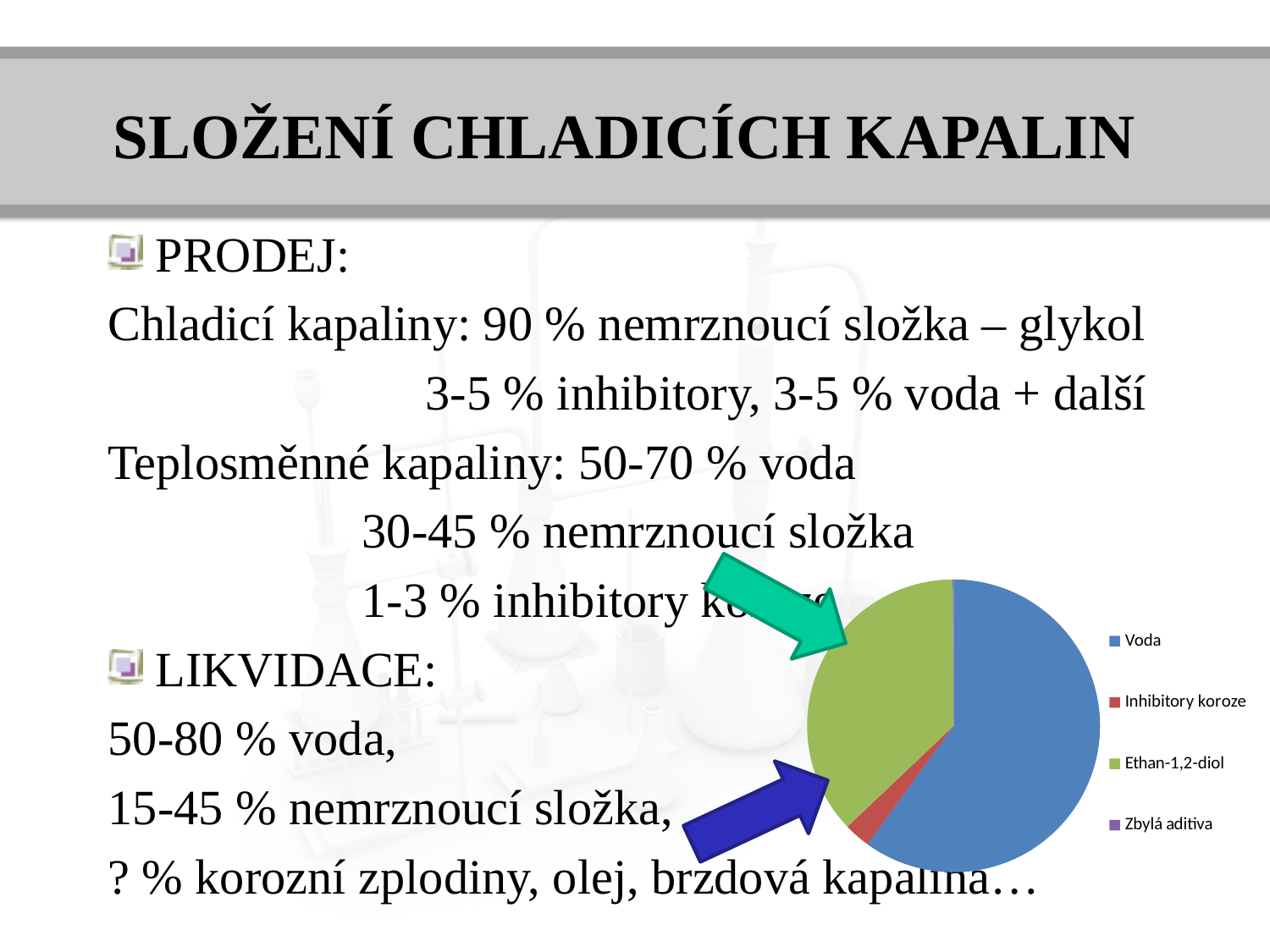
What kind of chart is shown on the slide? pie chart How many entries does the legend of the pie chart list? 4 Which slice is larger in the pie chart, Voda or Ethan-1,2-diol? Voda Which category has the largest slice in the pie chart? Voda What colour is the Voda slice in the pie chart? blue Which slice is larger in the pie chart, Voda or Inhibitory koroze? Voda Which legend entry of the pie chart is shown in green? Ethan-1,2-diol Which slice is larger in the pie chart, Ethan-1,2-diol or Inhibitory koroze? Ethan-1,2-diol